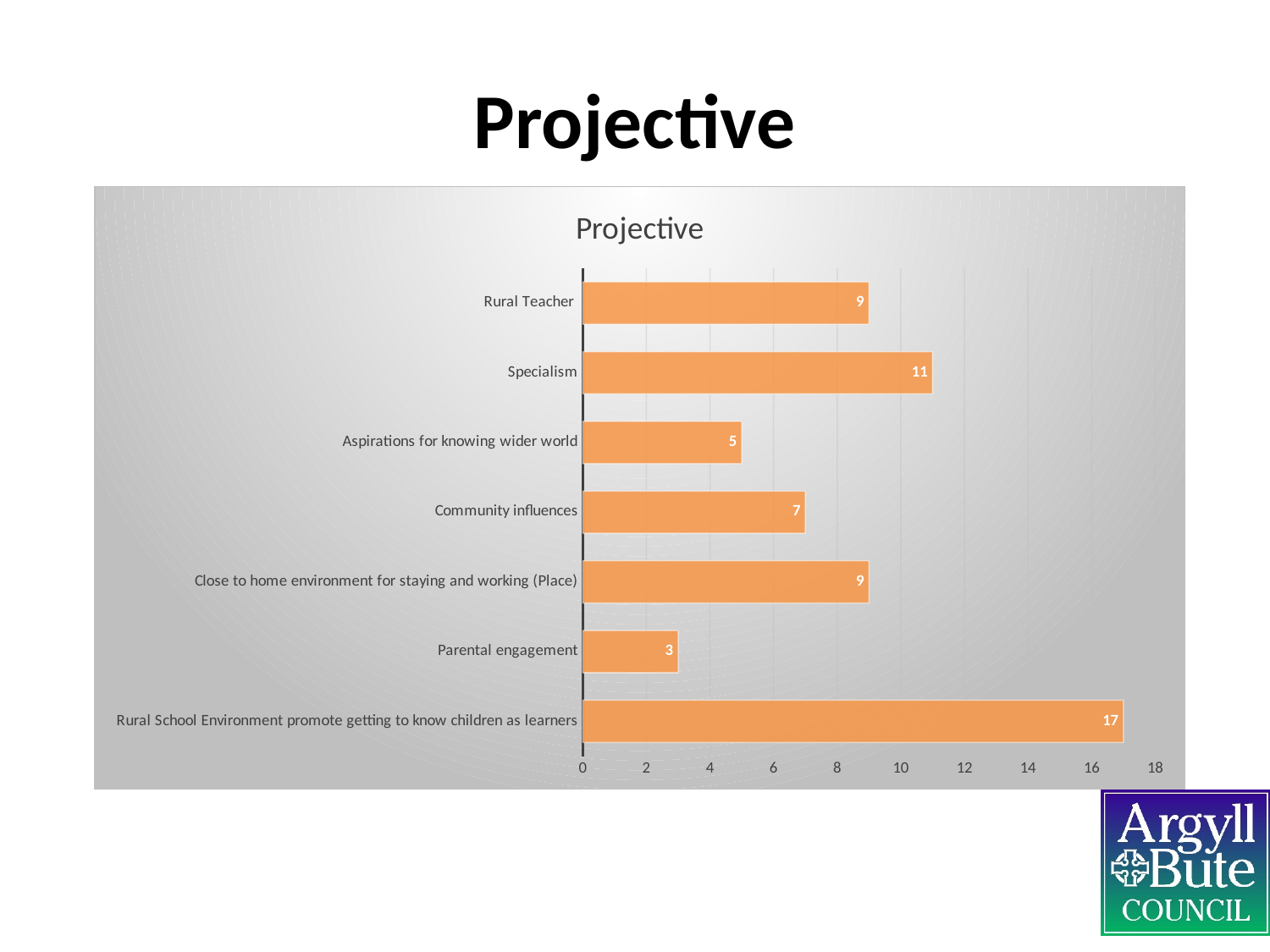
What is the title of the chart? Projective Which category has the lowest value? Parental engagement What kind of chart is shown? bar chart How many categories are shown in the chart? 7 What is the value for Community influences? 7 What is the difference between the values for Specialism and Aspirations for knowing wider world? 6 Which category has the highest value? Rural School Environment promote getting to know children as learners Is the value for Rural School Environment promote getting to know children as learners greater or less than 16? greater What is the value for Close to home environment for staying and working (Place)? 9 Which is larger, the value for Rural Teacher or the value for Community influences? Rural Teacher What is the value for Parental engagement? 3 What is the value for Specialism? 11